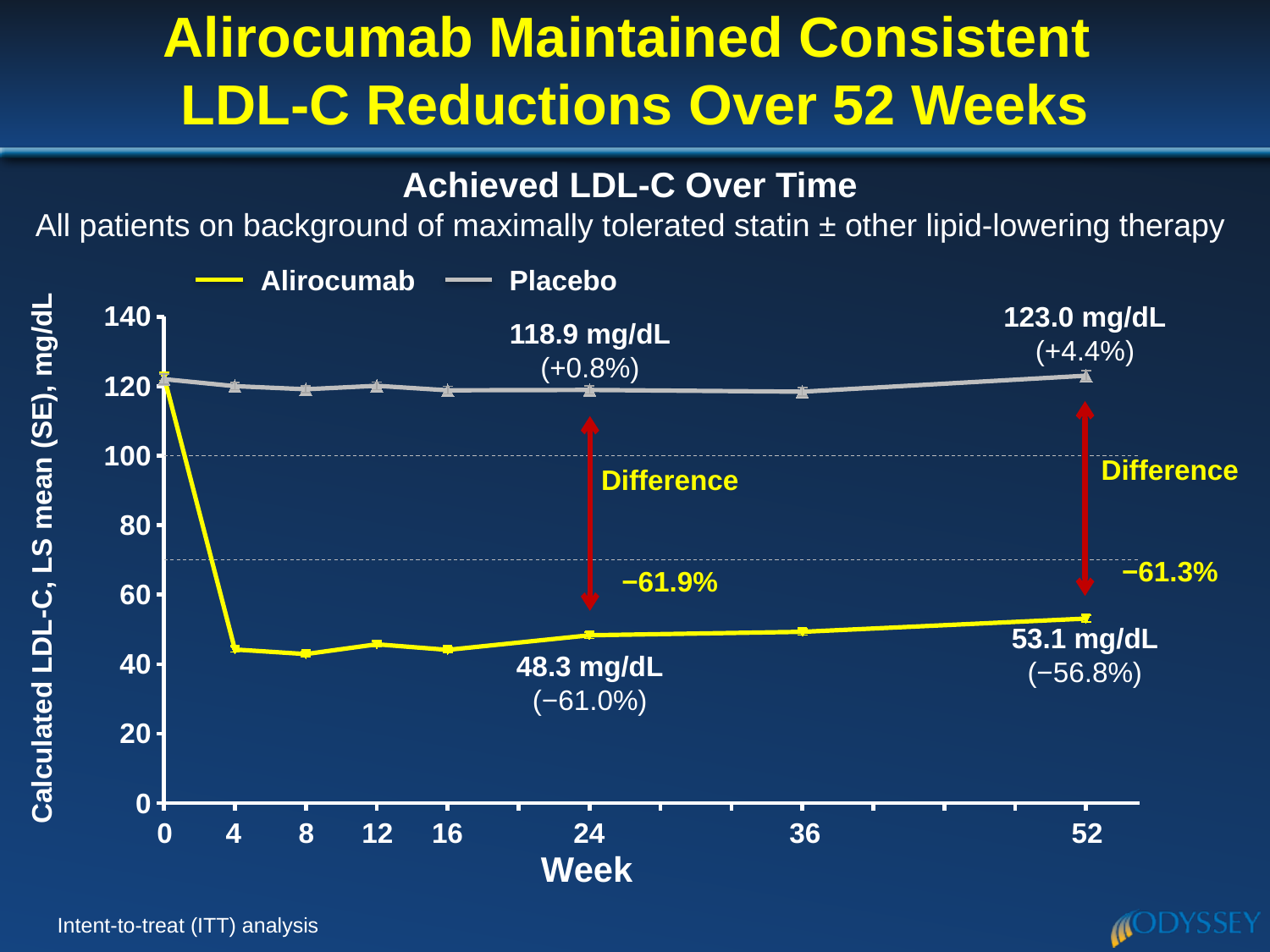
What is the labelled difference between Alirocumab and Placebo at week 52? −61.3% At week 52, which series has the higher LDL-C value, Alirocumab or Placebo? Placebo What is the Placebo LDL-C value labelled at week 24? 118.9 mg/dL By how much does the labelled Placebo value at week 52 exceed the labelled Placebo value at week 24? 4.1 mg/dL How many series does the legend list? 2 How many week values are marked on the x axis? 8 What is the Alirocumab LDL-C value labelled at week 52? 53.1 mg/dL What percentage change is shown for Placebo at week 52? +4.4% What percentage change is shown for Alirocumab at week 24? −61.0% What kind of chart is shown on the slide? line chart Is the Alirocumab value at week 4 greater or less than 60? less Between week 0 and week 4, does the Alirocumab line rise or fall? fall